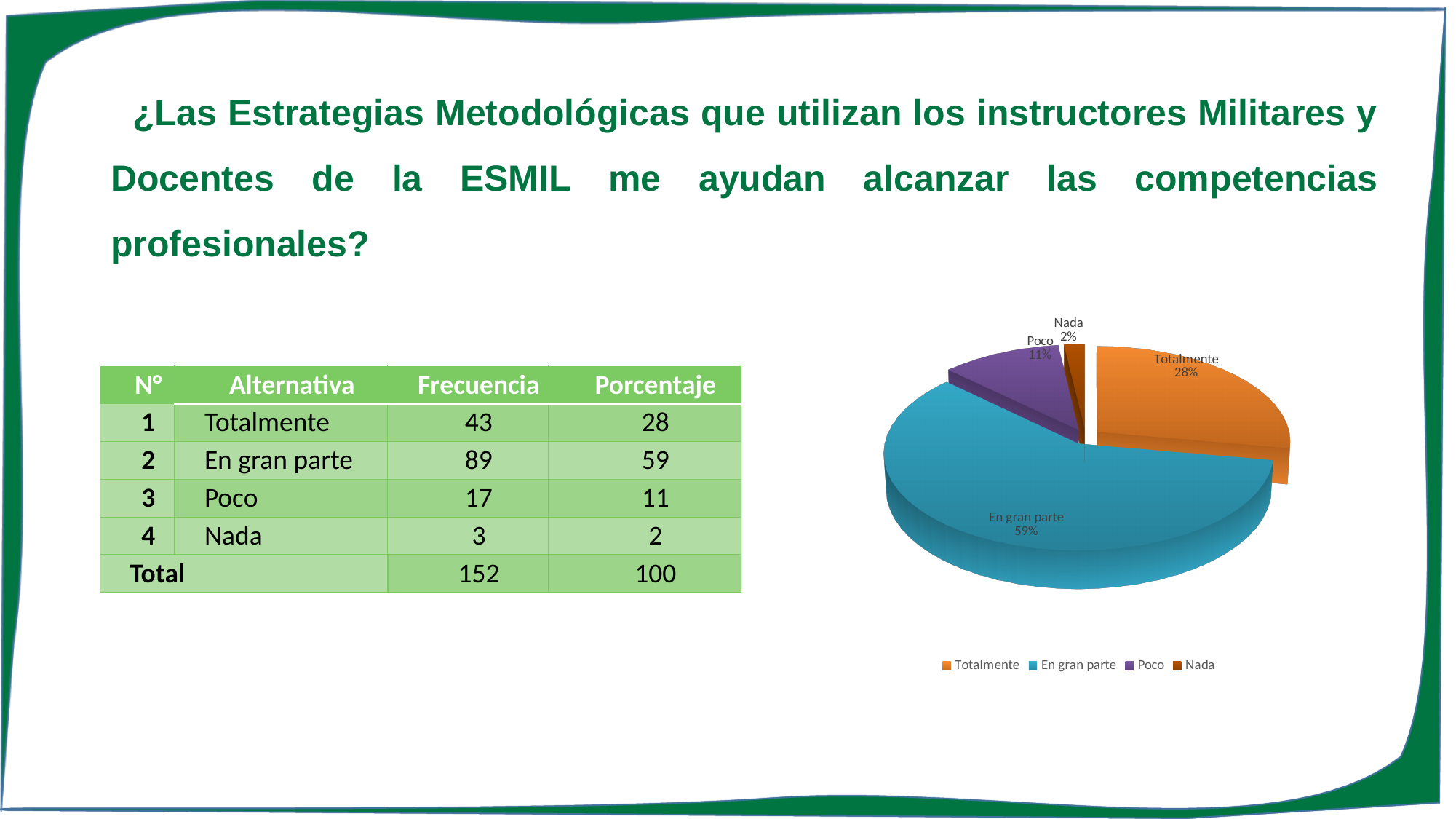
How many slices does the pie chart have? 4 What share of the pie does 'En gran parte' represent? 59% What colour is the 'En gran parte' slice in the pie chart? blue What share of the pie does 'Poco' represent? 11% How many entries does the legend list? 4 What share of the pie does 'Totalmente' represent? 28% Which slice is larger, 'Poco' or 'Totalmente'? Totalmente What kind of chart is shown on the slide? pie chart Which category has the smallest slice of the pie? Nada Which category has the largest slice of the pie? En gran parte What is the difference in percentage points between 'En gran parte' and 'Totalmente'? 31